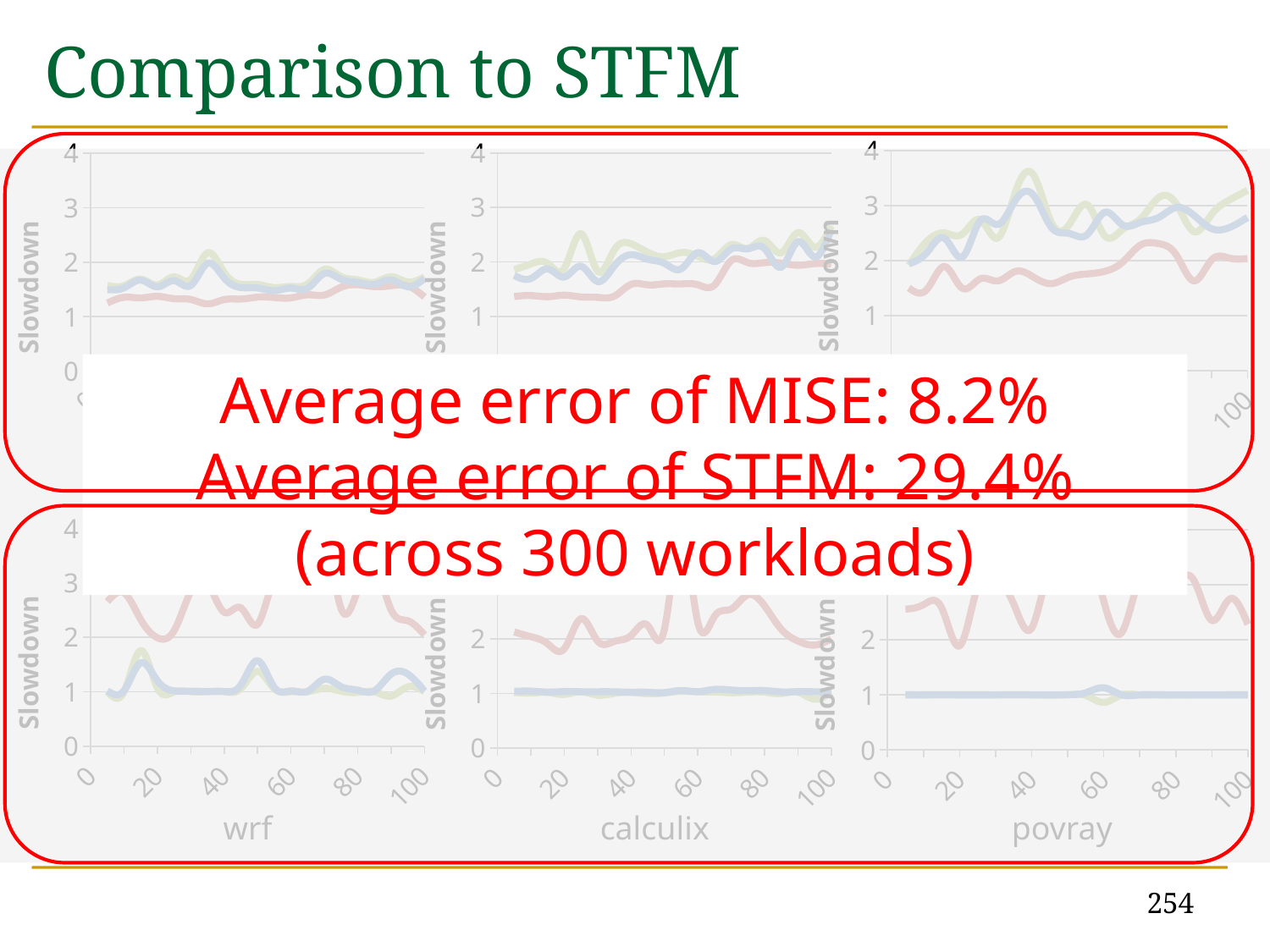
How many charts are shown on the slide? 6 In the bottom povray chart, is the value of the blue line at x=40 greater or less than 2? less In the top-right chart, does the blue line generally rise or fall from x=0 to x=40? rise In the top-left chart, is the value of the red line at x=20 greater or less than 2? less In the top-right chart, is the peak value of the green line greater or less than 3? greater What kind of charts are shown on the slide? line chart What is the x-axis label of the bottom-left chart? wrf In the bottom calculix chart, at x=40, which line is higher: the red line or the blue line? the red line What is the y-axis label on the charts? Slowdown In the top-right chart, at x=40, which line is higher: the green line or the red line? the green line